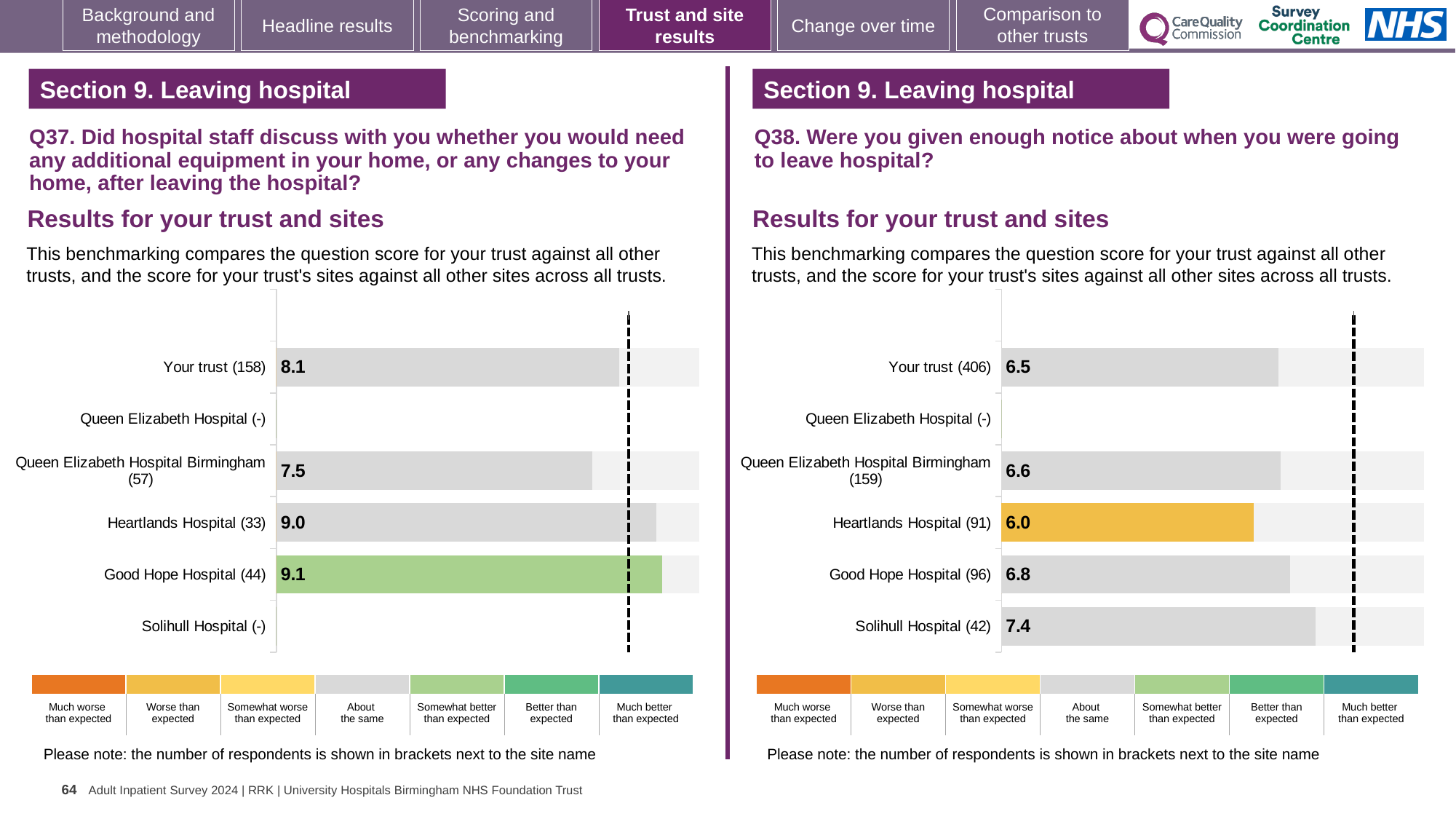
In the Q37 chart on the left, which bar is coloured green rather than grey? Good Hope Hospital (44) In the Q38 chart on the right, what is the score for Heartlands Hospital (91)? 6.0 In the Q38 chart on the right, which site has the highest score? Solihull Hospital (42) In the Q38 chart on the right, what is the difference between the scores for Solihull Hospital (42) and Heartlands Hospital (91)? 1.4 How many site/trust rows are listed in the Q37 chart on the left? 6 In the Q38 chart on the right, which is larger: the score for Good Hope Hospital (96) or Your trust (406)? Good Hope Hospital (96) In the Q37 chart on the left, what is the difference between the scores for Heartlands Hospital (33) and Queen Elizabeth Hospital Birmingham (57)? 1.5 In the Q37 chart on the left, which site has the lowest score among those with a value shown? Queen Elizabeth Hospital Birmingham (57) In the Q37 chart on the left, what is the score for Good Hope Hospital (44)? 9.1 In the Q38 chart on the right, what is the score for Solihull Hospital (42)? 7.4 What type of chart is used for the Q38 results on the right? Bar chart In the Q37 chart on the left, what is the score for Your trust (158)? 8.1